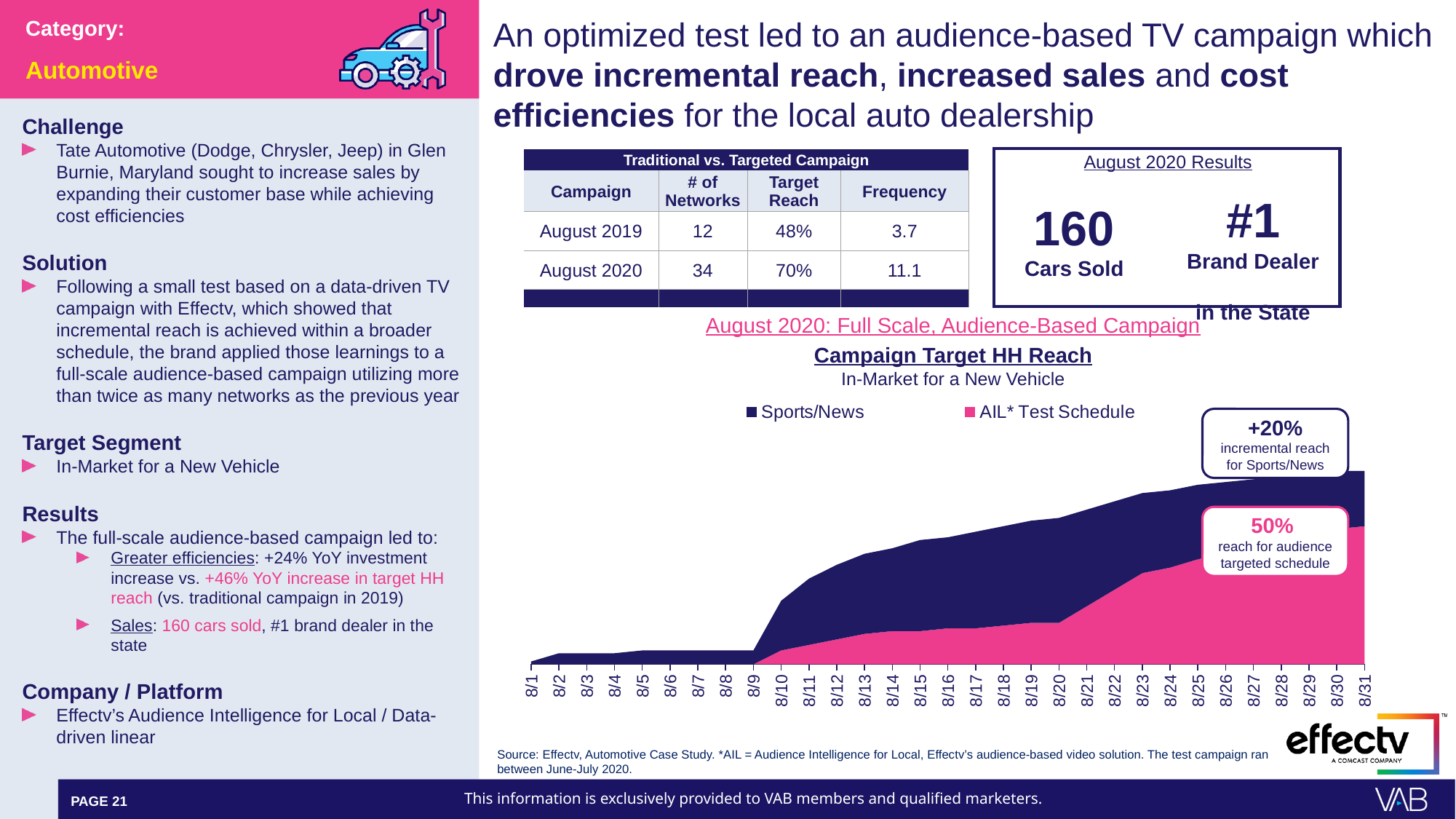
What is the last date on the x axis of the Campaign Target HH Reach chart? 8/31 What is the subtitle under the Campaign Target HH Reach chart title? In-Market for a New Vehicle On the Campaign Target HH Reach chart, which series is shown in pink? AIL* Test Schedule According to the callout on the Campaign Target HH Reach chart, what is the incremental reach for Sports/News? +20% How many dates are shown along the x axis of the Campaign Target HH Reach chart? 31 According to the callout on the Campaign Target HH Reach chart, what is the reach for the audience targeted schedule? 50% Do the values in the Campaign Target HH Reach chart rise or fall from 8/1 to 8/31? Rise On the Campaign Target HH Reach chart at 8/31, which series contributes the larger share of reach, Sports/News or AIL* Test Schedule? AIL* Test Schedule What kind of chart is the Campaign Target HH Reach chart? Stacked area chart What are the two series shown in the legend of the Campaign Target HH Reach chart? Sports/News and AIL* Test Schedule How many series does the legend of the Campaign Target HH Reach chart list? 2